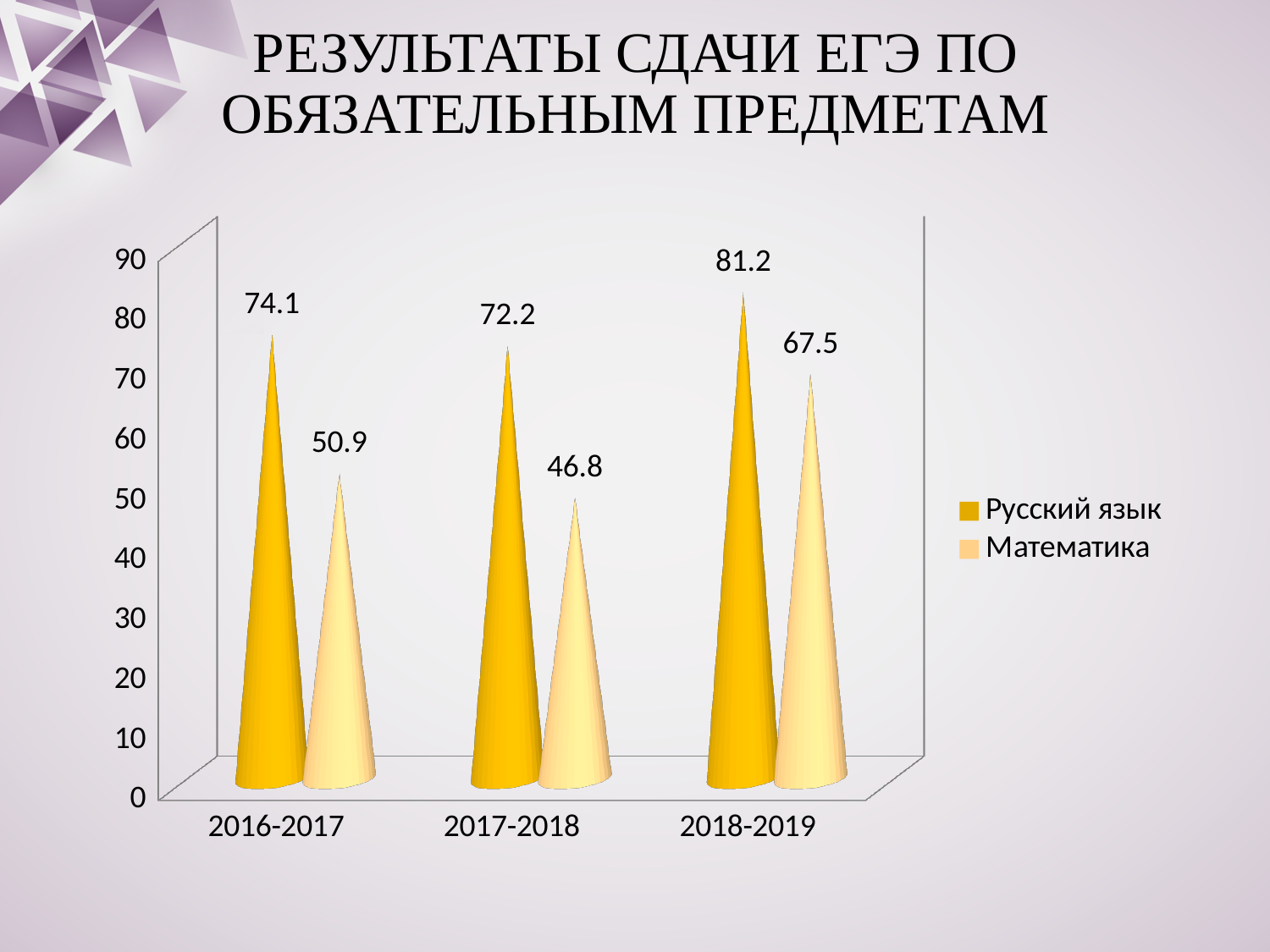
How many year categories are shown on the x axis? 3 Does the value for Математика rise or fall from 2017-2018 to 2018-2019? Rise Which is larger in 2016-2017: Русский язык or Математика? Русский язык How many series does the legend list? 2 What kind of chart is shown on the slide? Bar chart What is the difference between Русский язык and Математика in 2018-2019? 13.7 In which year is the value for Русский язык highest? 2018-2019 What is the value for Русский язык in 2016-2017? 74.1 What is the value for Математика in 2017-2018? 46.8 In which year is the value for Математика lowest? 2017-2018 What is the value for Математика in 2018-2019? 67.5 What is the title of the chart on the slide? РЕЗУЛЬТАТЫ СДАЧИ ЕГЭ ПО ОБЯЗАТЕЛЬНЫМ ПРЕДМЕТАМ